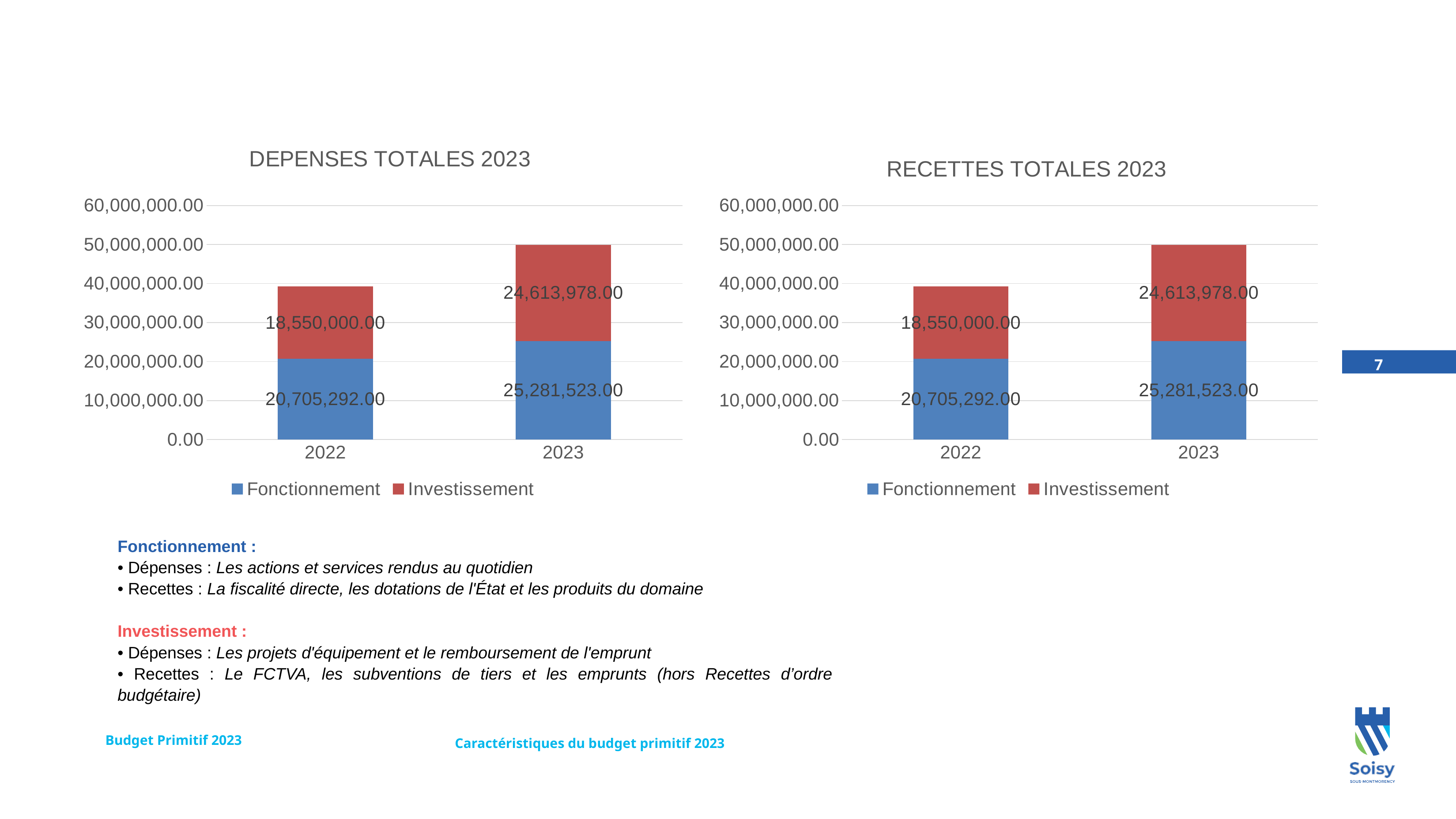
In the DEPENSES TOTALES 2023 chart, what is the Investissement value for 2023? 24,613,978.00 In the RECETTES TOTALES 2023 chart, what is the total of the stacked bar for 2022? 39,255,292.00 In the RECETTES TOTALES 2023 chart, what is the Fonctionnement value for 2023? 25,281,523.00 In the DEPENSES TOTALES 2023 chart, what is the total of the stacked bar for 2023? 49,895,501.00 In the RECETTES TOTALES 2023 chart, what is the difference between the Investissement values for 2023 and 2022? 6,063,978.00 In the DEPENSES TOTALES 2023 chart, what is the Fonctionnement value for 2022? 20,705,292.00 In the DEPENSES TOTALES 2023 chart, by how much does the Fonctionnement value increase from 2022 to 2023? 4,576,231.00 In the DEPENSES TOTALES 2023 chart, which is larger for 2023: Fonctionnement or Investissement? Fonctionnement In the RECETTES TOTALES 2023 chart, what is the Investissement value for 2022? 18,550,000.00 What kind of chart is the RECETTES TOTALES 2023 chart? stacked bar chart How many series does the legend of the DEPENSES TOTALES 2023 chart list? 2 In the RECETTES TOTALES 2023 chart, does the total stacked value rise or fall from 2022 to 2023? rise